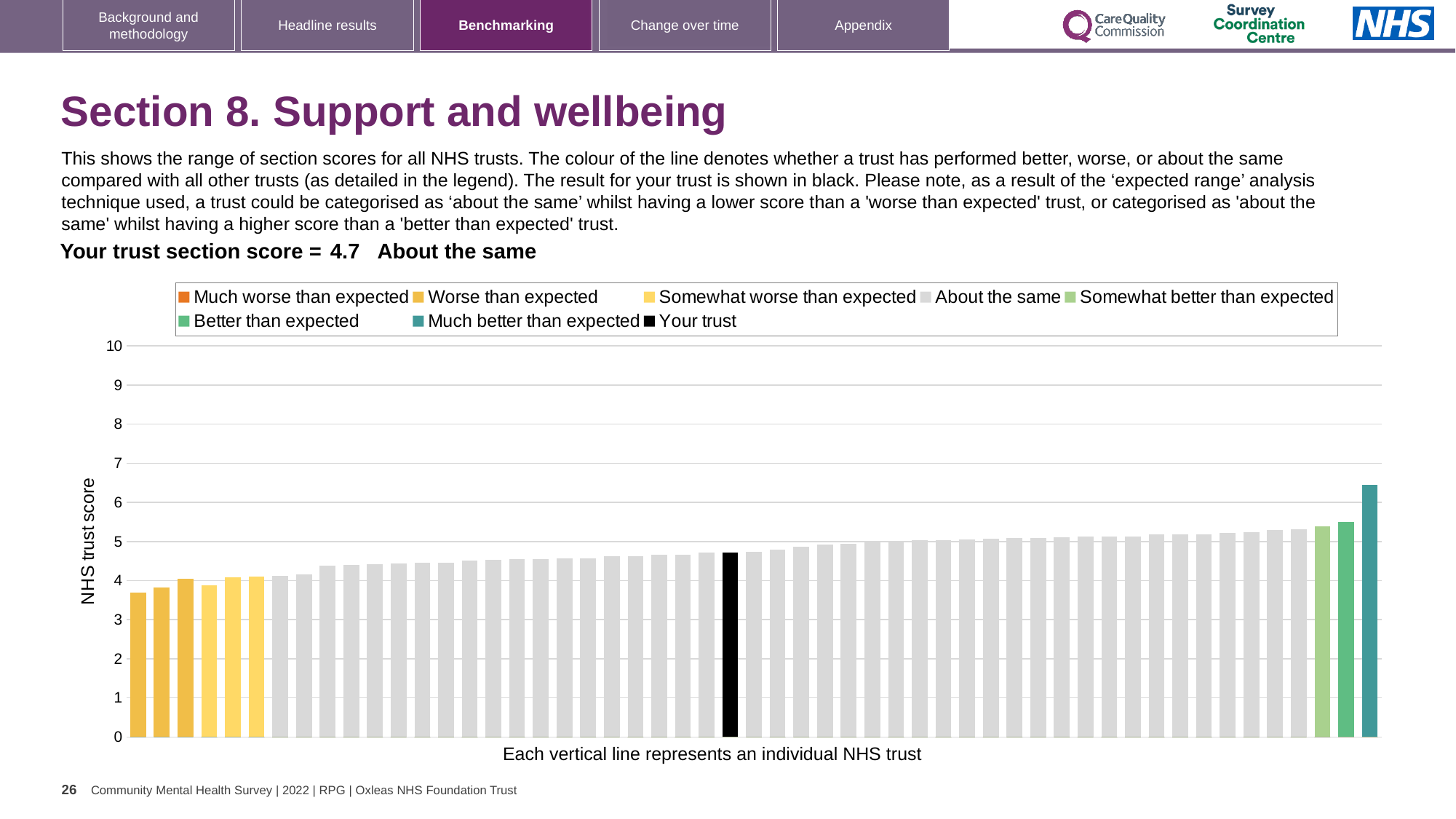
How many entries does the chart legend list? 8 What is the section score for your trust shown on the chart? 4.7 Which benchmarking category is your trust placed in for this section? About the same Is the value of the shortest bar greater or less than 4? less Is the value of the tallest bar greater or less than 7? less What is the label on the vertical axis of the chart? NHS trust score Do the bar values rise or fall from left to right along the x axis? rise Is the value of the tallest bar greater or less than 6? greater What kind of chart is shown on the slide? bar chart Which legend category does the highest-scoring trust belong to? Much better than expected